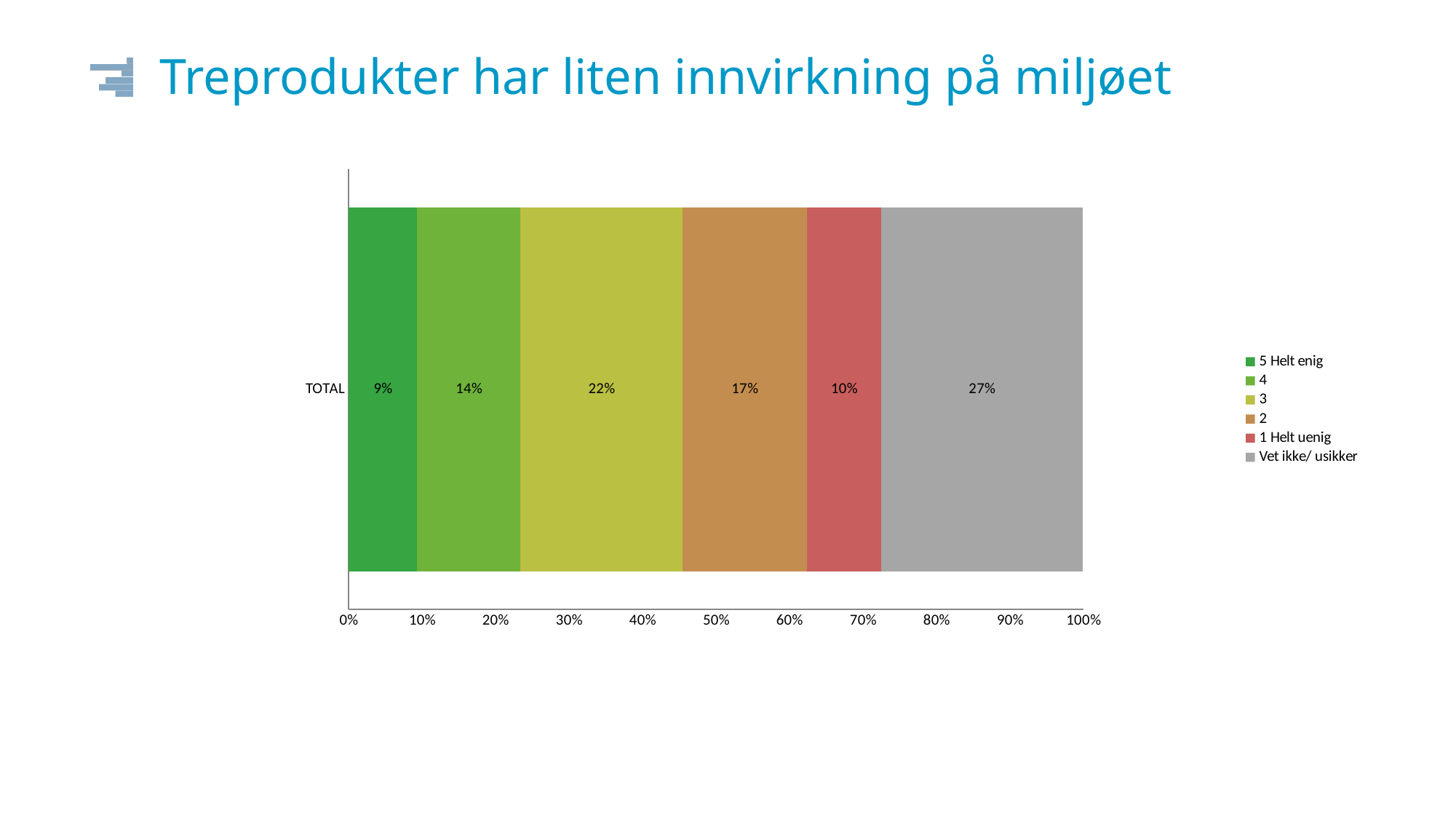
How many series does the legend list? 6 Which is larger in the TOTAL bar: the "4" segment or the "1 Helt uenig" segment? 4 What kind of chart is shown on the slide? Stacked bar chart What is the value for the "3" segment in the TOTAL bar? 22% What is the difference between the "3" segment and the "2" segment in the TOTAL bar? 5% What percentage of respondents answered "5 Helt enig" for TOTAL? 9% What is the total of all segments in the TOTAL bar? 99% What is the title of the slide containing the chart? Treprodukter har liten innvirkning på miljøet What is the value for "1 Helt uenig" in the TOTAL bar? 10% What is the value for the "Vet ikke/ usikker" segment in the TOTAL bar? 27% Which series has the largest segment in the TOTAL bar? Vet ikke/ usikker Which series has the smallest segment in the TOTAL bar? 5 Helt enig